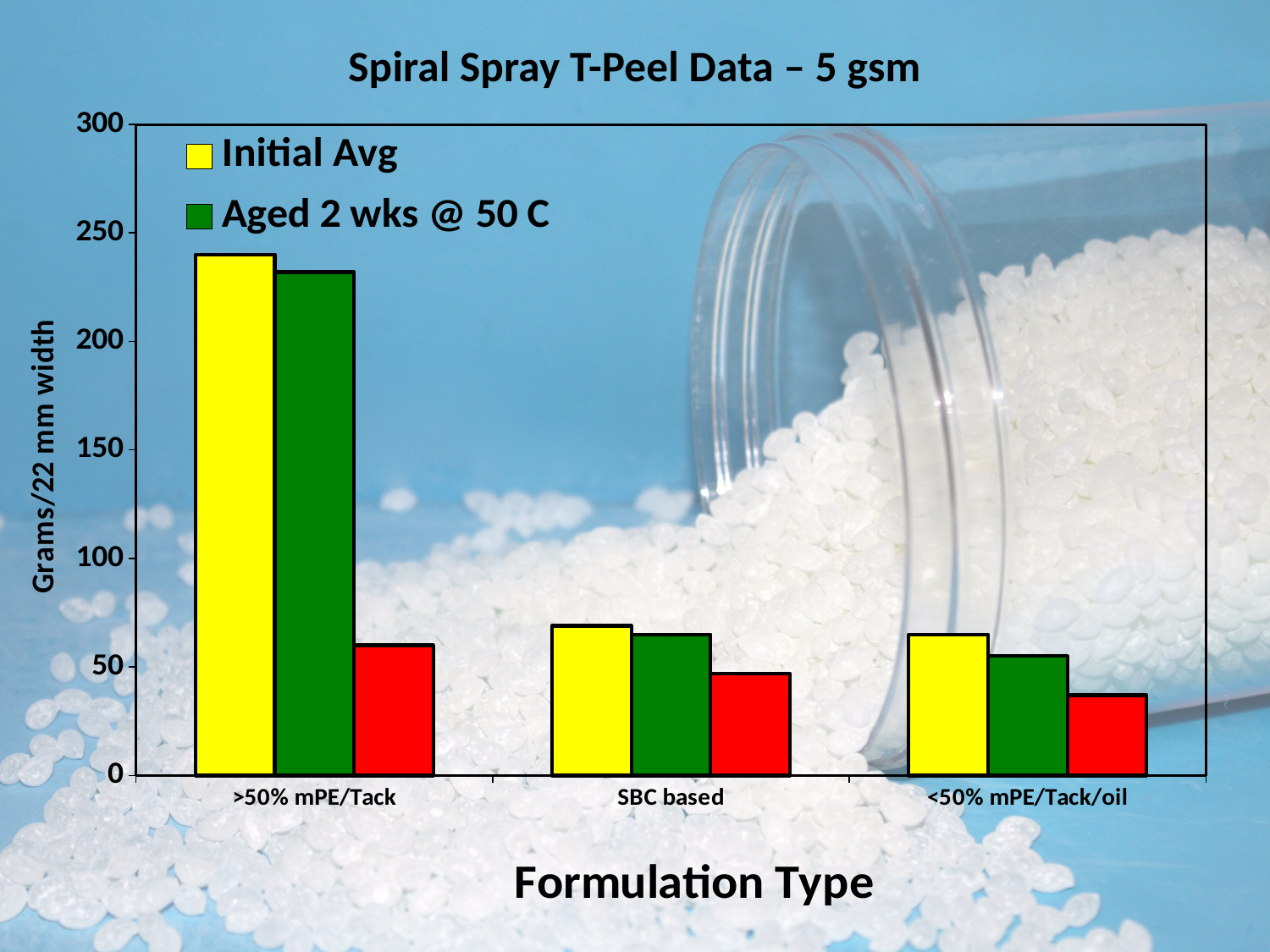
What is the label of the y axis? Grams/22 mm width Is the Initial Avg value for <50% mPE/Tack/oil greater or less than 50? greater How many series does the legend list? 2 What kind of chart is shown on the slide? bar chart Is the Initial Avg value for >50% mPE/Tack greater or less than 200? greater Which is larger for >50% mPE/Tack: the Initial Avg value or the Aged 2 wks @ 50 C value? Initial Avg Which formulation type has the highest Initial Avg value? >50% mPE/Tack What is the title of the chart? Spiral Spray T-Peel Data – 5 gsm Is the Aged 2 wks @ 50 C value for SBC based greater or less than 100? less How many formulation types are shown on the x axis? 3 Which is larger: the Initial Avg value for >50% mPE/Tack or the Initial Avg value for SBC based? >50% mPE/Tack Which formulation type has the lowest Aged 2 wks @ 50 C value? <50% mPE/Tack/oil